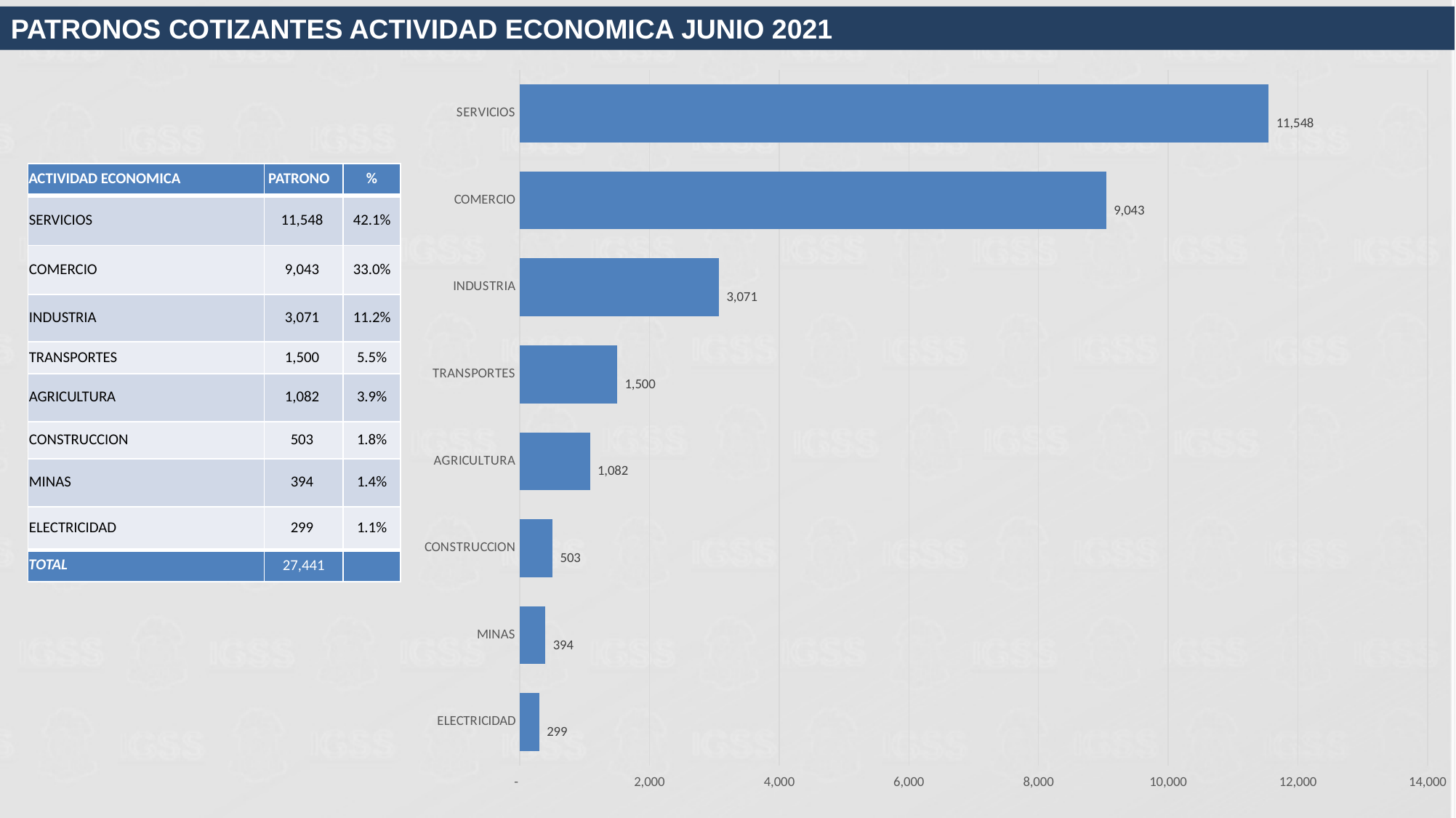
What kind of chart is shown on the slide? bar chart Is the value for COMERCIO greater or less than 8,000? greater What is the value for SERVICIOS in the bar chart? 11,548 Which category has the highest value in the bar chart? SERVICIOS Which category has the lowest value in the bar chart? ELECTRICIDAD What is the difference between the values for CONSTRUCCION and MINAS? 109 What is the difference between the values for SERVICIOS and COMERCIO? 2,505 Which is larger, the value for INDUSTRIA or the value for TRANSPORTES? INDUSTRIA What is the title of the slide containing the chart? PATRONOS COTIZANTES ACTIVIDAD ECONOMICA JUNIO 2021 How many categories are shown in the bar chart? 8 What is the value for MINAS in the bar chart? 394 What is the value for AGRICULTURA in the bar chart? 1,082